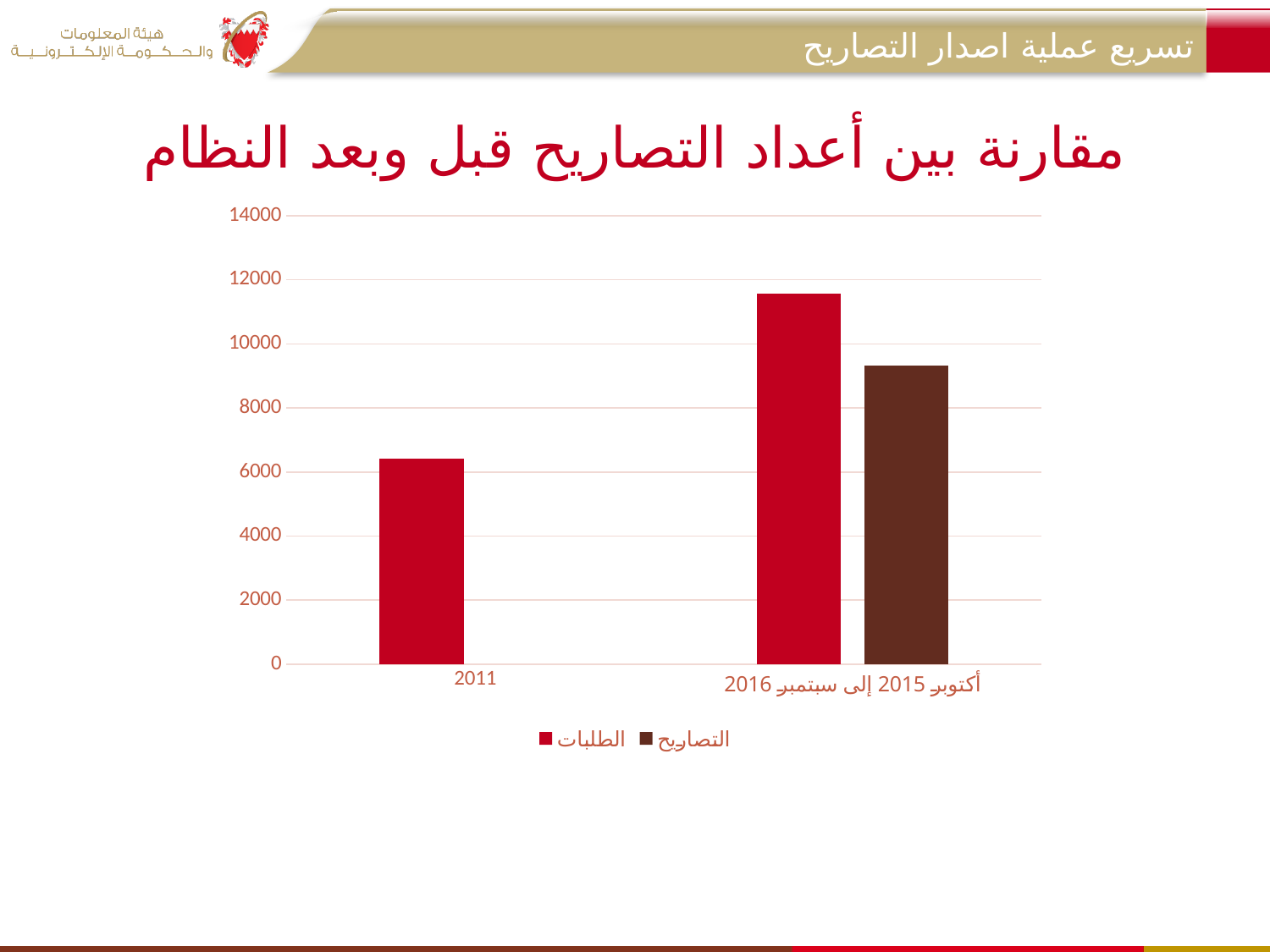
Is the value of the red bar for 2011 greater or less than 6000? greater Is the value of the red bar for أكتوبر 2015 إلى سبتمبر 2016 greater or less than 12000? less Is the value of the brown bar for أكتوبر 2015 إلى سبتمبر 2016 greater or less than 8000? greater Which category has the tallest bar in the chart? أكتوبر 2015 إلى سبتمبر 2016 How many series does the chart legend list? 2 What is the label of the second category on the x axis? أكتوبر 2015 إلى سبتمبر 2016 How many categories are shown on the x axis of the chart? 2 What is the title of the chart? مقارنة بين أعداد التصاريح قبل وبعد النظام What kind of chart is shown on the slide? bar chart